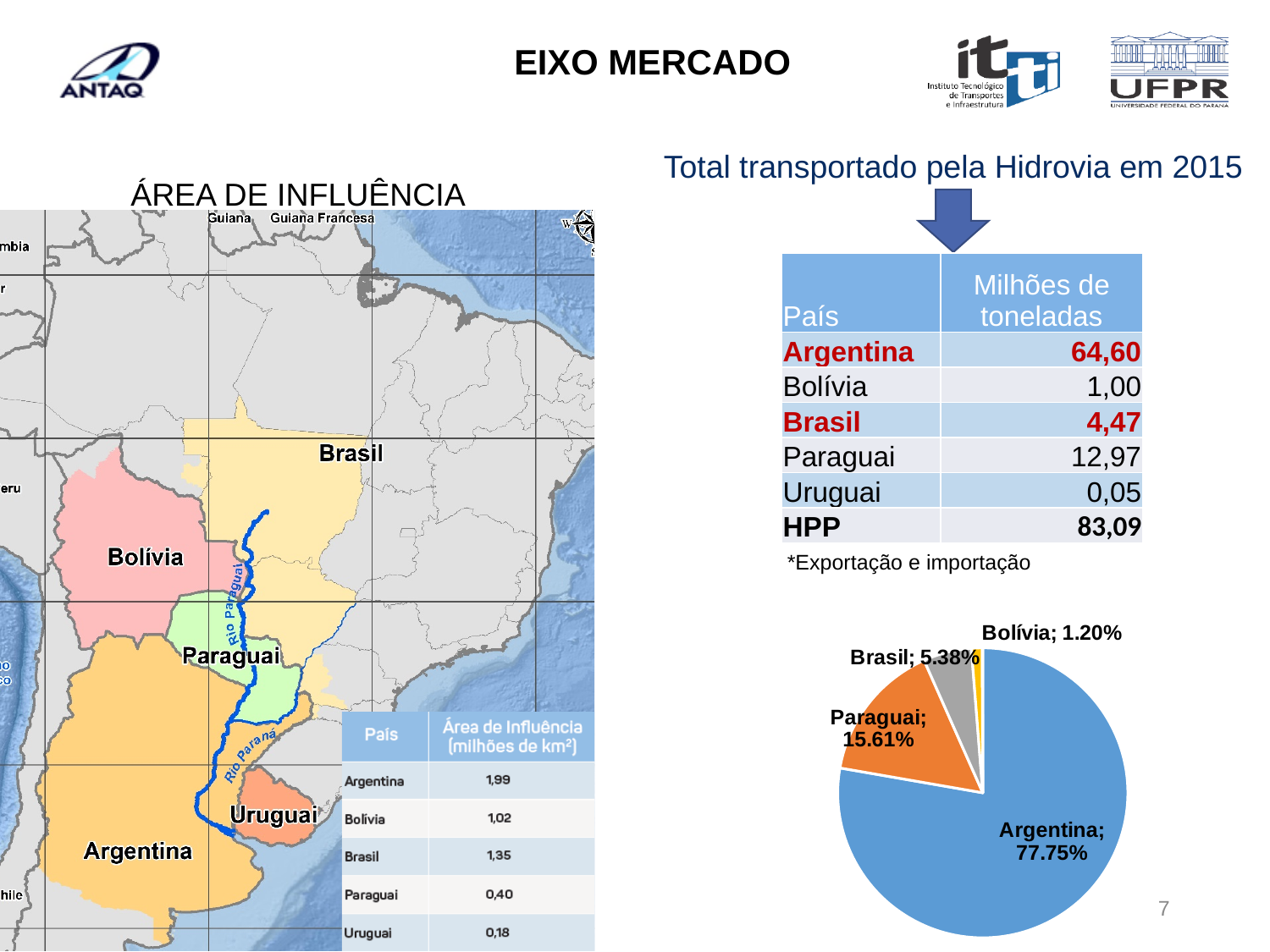
In the pie chart, what is the difference in percentage points between Argentina's share and Paraguai's share? 62.14 Which labelled country has the smallest slice in the pie chart? Bolívia What colour is the Paraguai slice in the pie chart? orange In the pie chart, which slice is larger: Paraguai or Brasil? Paraguai In the pie chart, what is the difference in percentage points between Brasil's share and Bolívia's share? 4.18 In the pie chart, what share is shown for Brasil? 5.38% Which country has the largest slice in the pie chart? Argentina In the pie chart, what share is shown for Bolívia? 1.20% In the pie chart, what share is shown for Argentina? 77.75% In the pie chart, what share is shown for Paraguai? 15.61% What colour is the Argentina slice in the pie chart? blue What kind of chart is shown at the bottom right of the slide? pie chart